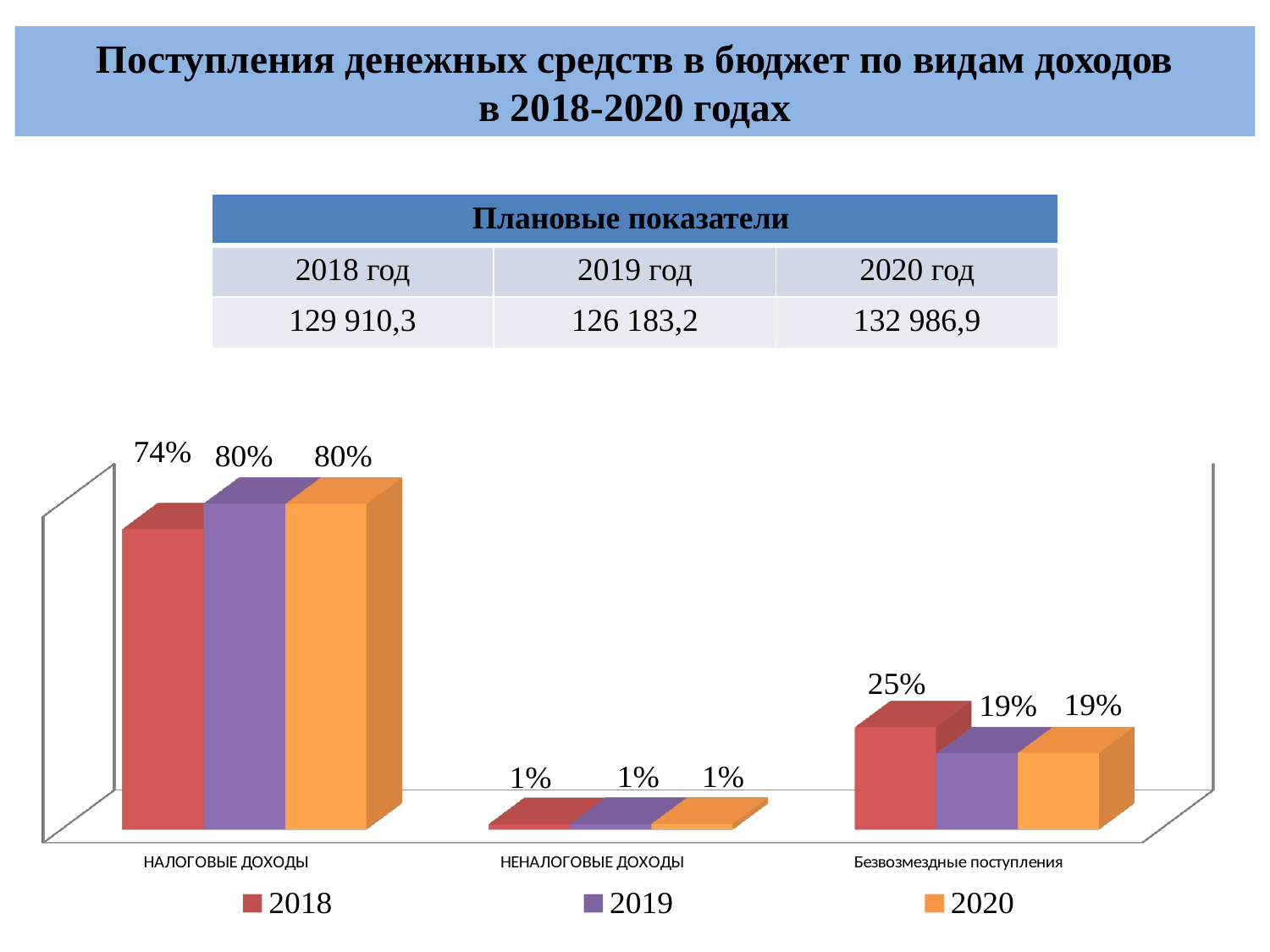
What is the value for НЕНАЛОГОВЫЕ ДОХОДЫ in 2020? 1% What is the value for Безвозмездные поступления in 2019? 19% Which category has the highest value in 2019? НАЛОГОВЫЕ ДОХОДЫ Which is larger for Безвозмездные поступления: the 2018 value or the 2020 value? 2018 What is the difference between the 2018 and 2019 values for НАЛОГОВЫЕ ДОХОДЫ? 6% How many series does the legend list? 3 What is the value for НАЛОГОВЫЕ ДОХОДЫ in 2018? 74% How many categories are shown on the x axis of the chart? 3 What is the value for НАЛОГОВЫЕ ДОХОДЫ in 2020? 80% What kind of chart is shown on the slide? Bar chart Which category has the lowest value in 2018? НЕНАЛОГОВЫЕ ДОХОДЫ What is the difference between the 2018 and 2020 values for Безвозмездные поступления? 6%